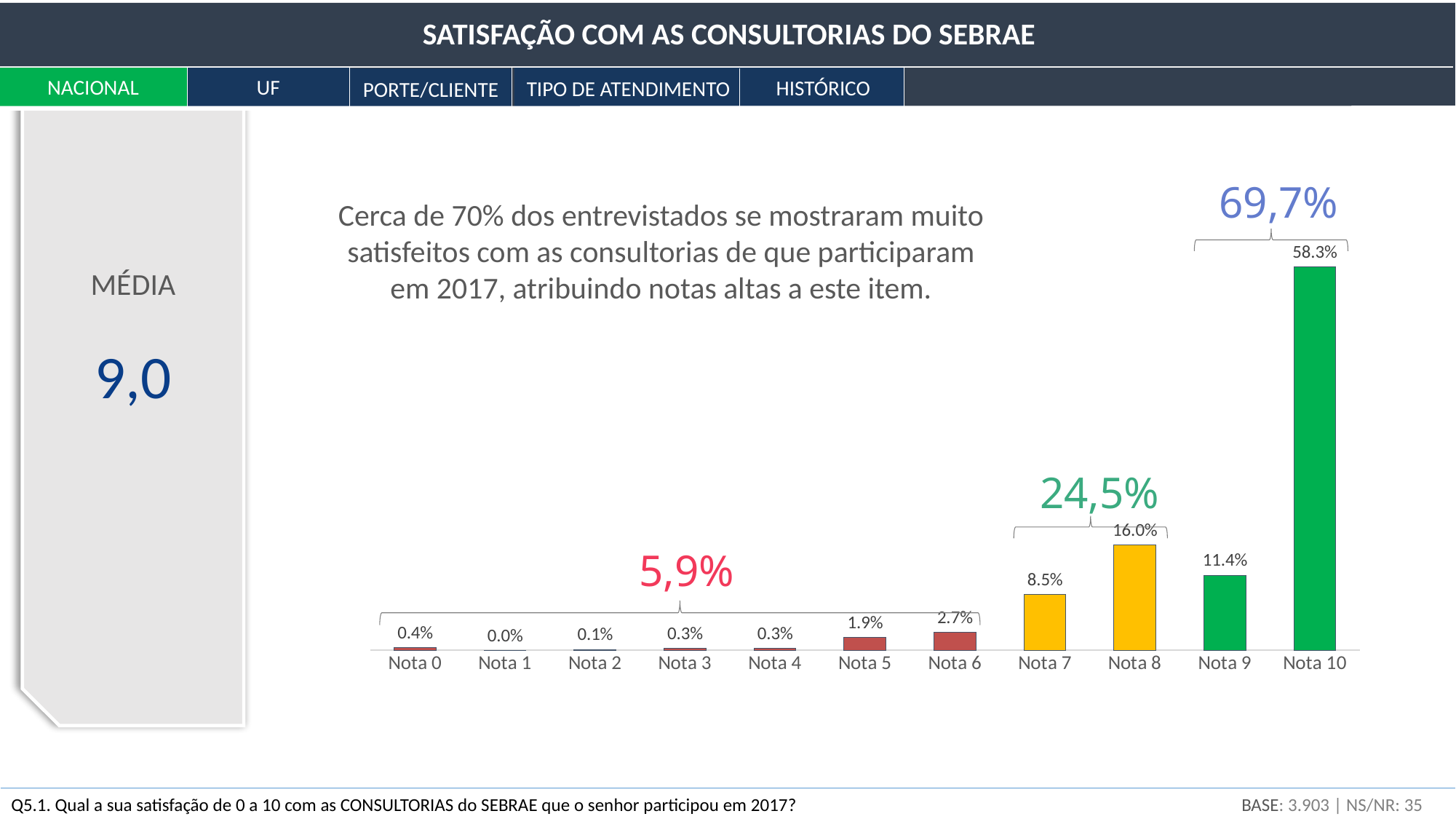
What is the value shown for MÉDIA on the left panel of the slide? 9,0 What kind of chart is shown on the slide? Bar chart Which category has the highest value? Nota 10 What is the value for Nota 8? 16.0% Which is larger, the value for Nota 7 or the value for Nota 9? Nota 9 How many categories are shown on the x axis? 11 What is the value for Nota 5? 1.9% What is the difference between the values for Nota 8 and Nota 9? 4.6% What is the difference between the values for Nota 10 and Nota 8? 42.3% Which category has the lowest value? Nota 1 What is the value for Nota 10? 58.3% What combined percentage is shown above the bracket grouping Nota 7 and Nota 8? 24,5%